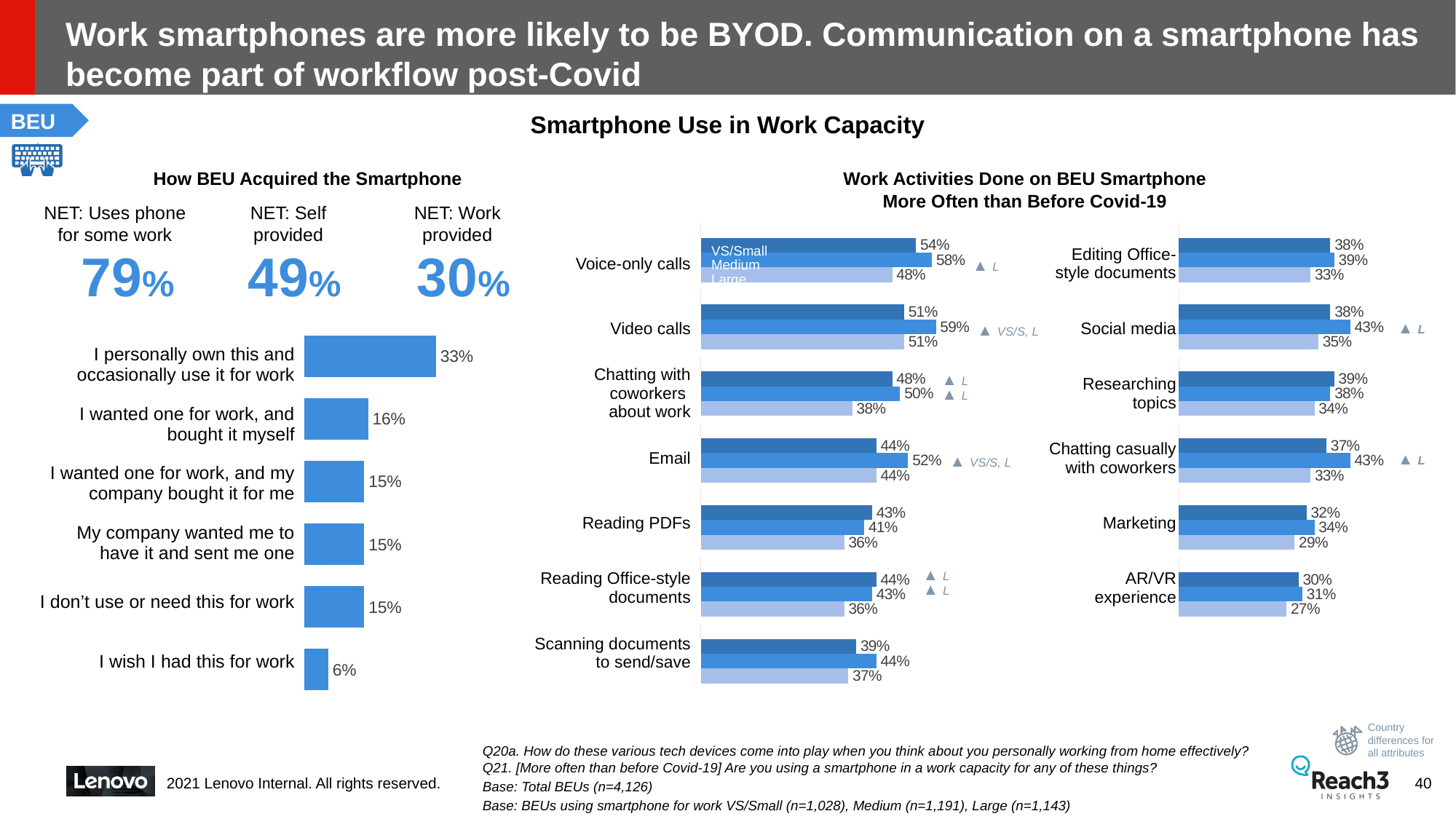
In the 'Work Activities Done on BEU Smartphone More Often than Before Covid-19' chart, what is the Medium value for Video calls? 59% What kind of chart is 'How BEU Acquired the Smartphone'? Bar chart In the 'Work Activities Done on BEU Smartphone More Often than Before Covid-19' chart, what is the Large value for AR/VR experience? 27% In the 'How BEU Acquired the Smartphone' chart, what is the difference between 'I personally own this and occasionally use it for work' and 'I wanted one for work, and bought it myself'? 17% How many series does the legend list in the 'Work Activities Done on BEU Smartphone More Often than Before Covid-19' chart? 3 In the 'How BEU Acquired the Smartphone' chart, which category has the lowest value? I wish I had this for work What is the NET: Uses phone for some work value shown on the slide? 79% How many categories are shown in the 'How BEU Acquired the Smartphone' chart? 6 In the 'Work Activities Done on BEU Smartphone More Often than Before Covid-19' chart, which activity has the highest Medium value? Video calls In the 'Work Activities Done on BEU Smartphone More Often than Before Covid-19' chart, which is larger for Email: the Medium value or the Large value? Medium In the 'Work Activities Done on BEU Smartphone More Often than Before Covid-19' chart, what is the difference between the Medium and Large values for Chatting with coworkers about work? 12% In the 'How BEU Acquired the Smartphone' chart, what is the value for 'I personally own this and occasionally use it for work'? 33%